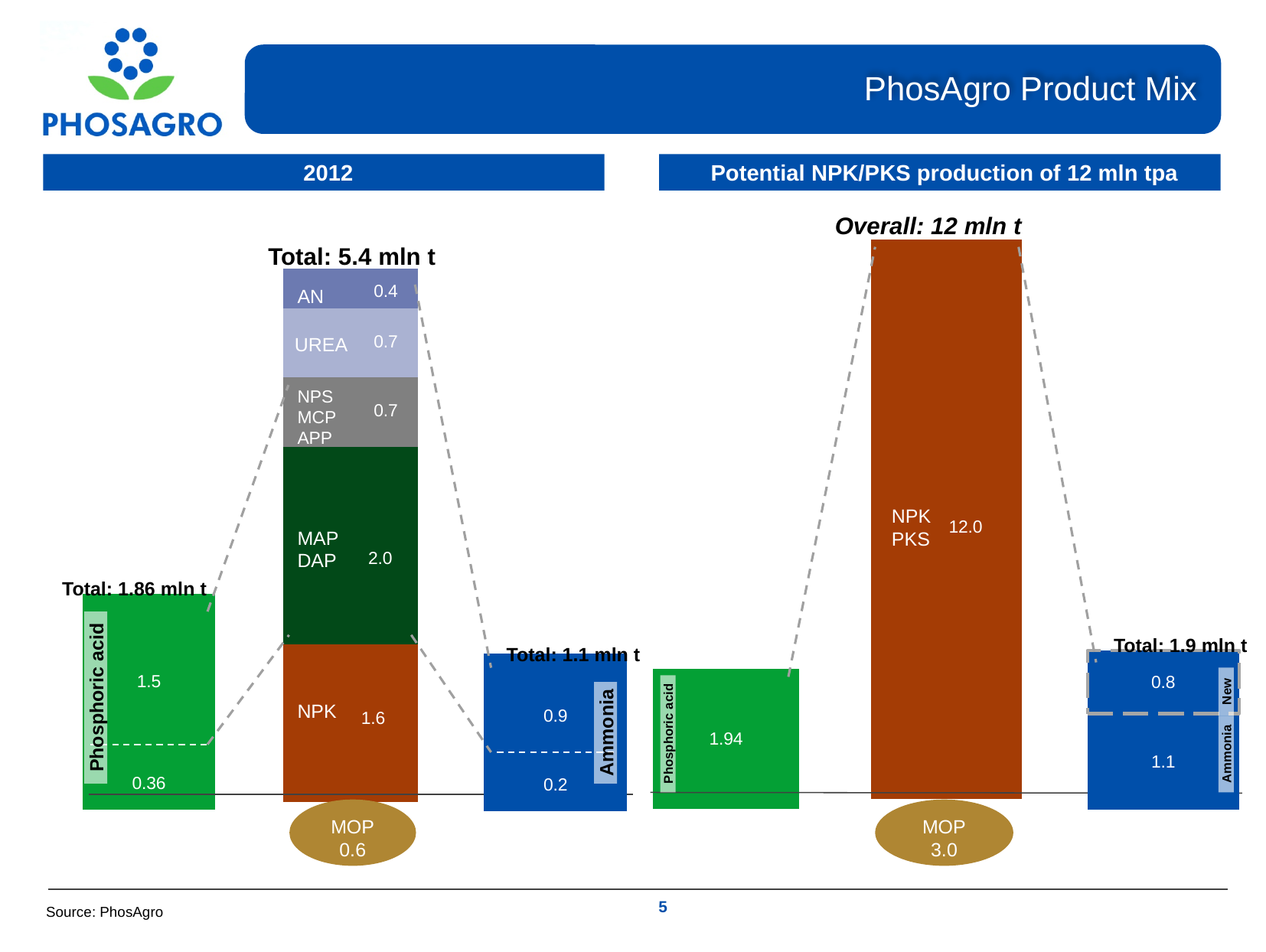
In the 2012 chart, what is the value shown for the NPK segment? 1.6 In the 2012 chart, what is the value shown for the MAP/DAP segment of the product mix bar? 2.0 In the 2012 chart, how many segments make up the product mix stacked bar? 5 In the 2012 chart, which segment of the product mix stacked bar is the largest? MAP/DAP In the Potential NPK/PKS production chart, what is the value shown for Phosphoric acid? 1.94 Which is larger: the Ammonia total in the 2012 chart or the Ammonia total in the Potential NPK/PKS production chart? Potential NPK/PKS production chart What kind of chart is used on this slide? Bar chart In the 2012 chart, what is the total of the product mix stacked bar? 5.4 mln t What is the difference between the MOP value in the Potential NPK/PKS production chart and the MOP value in the 2012 chart? 2.4 In the 2012 chart, which segment of the product mix stacked bar is the smallest? AN In the Potential NPK/PKS production chart, what is the value shown for MOP? 3.0 In the Potential NPK/PKS production chart, what is the value shown for NPK/PKS? 12.0